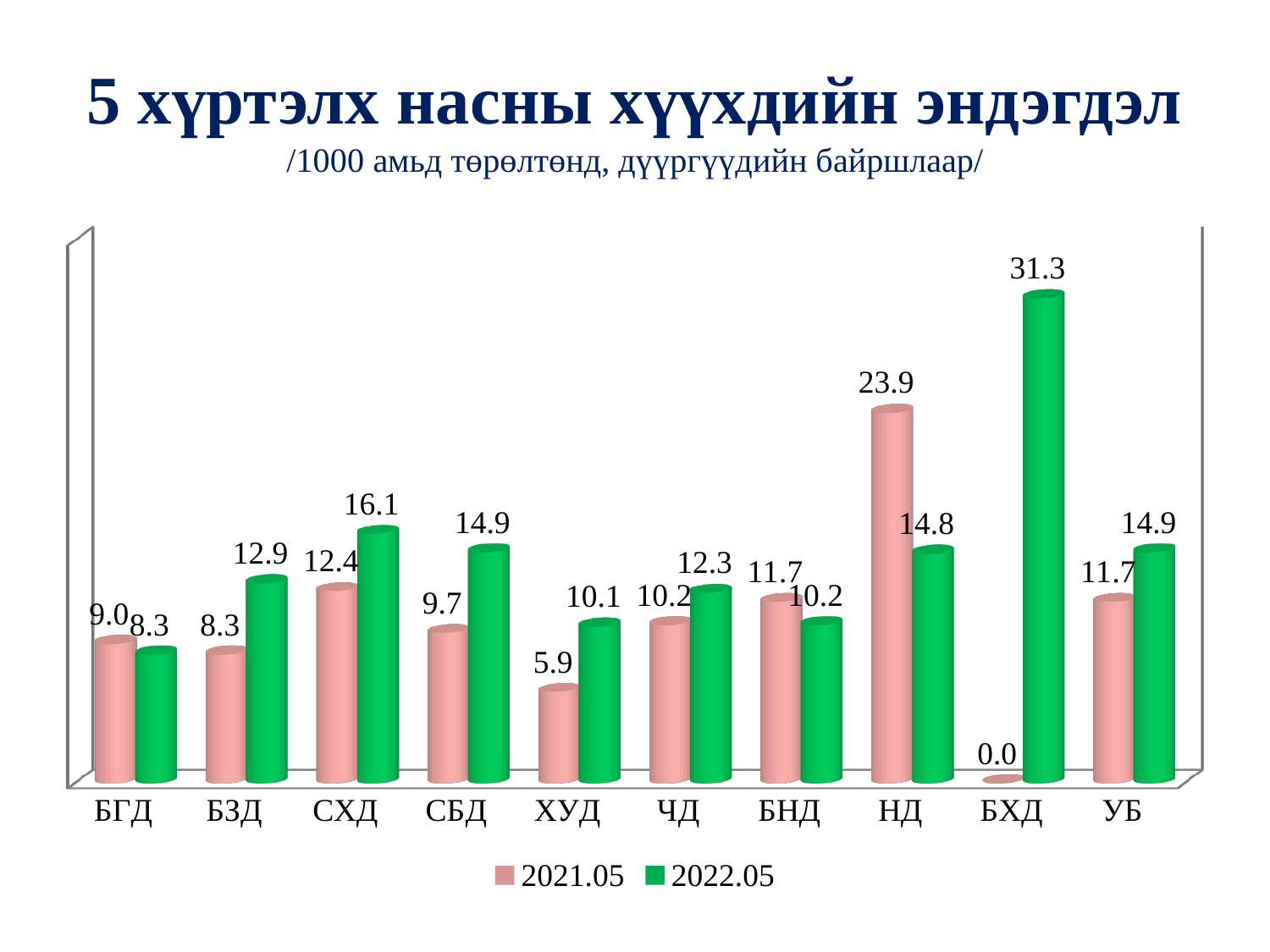
What kind of chart is shown on the slide? Bar chart How many categories are shown on the x axis? 10 What is the value for УБ in the 2022.05 series? 14.9 What is the value for ХУД in the 2021.05 series? 5.9 What is the value for БХД in the 2022.05 series? 31.3 Which is larger for НД: the 2021.05 value or the 2022.05 value? 2021.05 Which colour represents the 2022.05 series? Green What is the difference between the 2022.05 and 2021.05 values for СХД? 3.7 Which category has the lowest value in the 2021.05 series? БХД How many series does the legend list? 2 Which category has the highest value in the 2022.05 series? БХД What is the value for НД in the 2021.05 series? 23.9